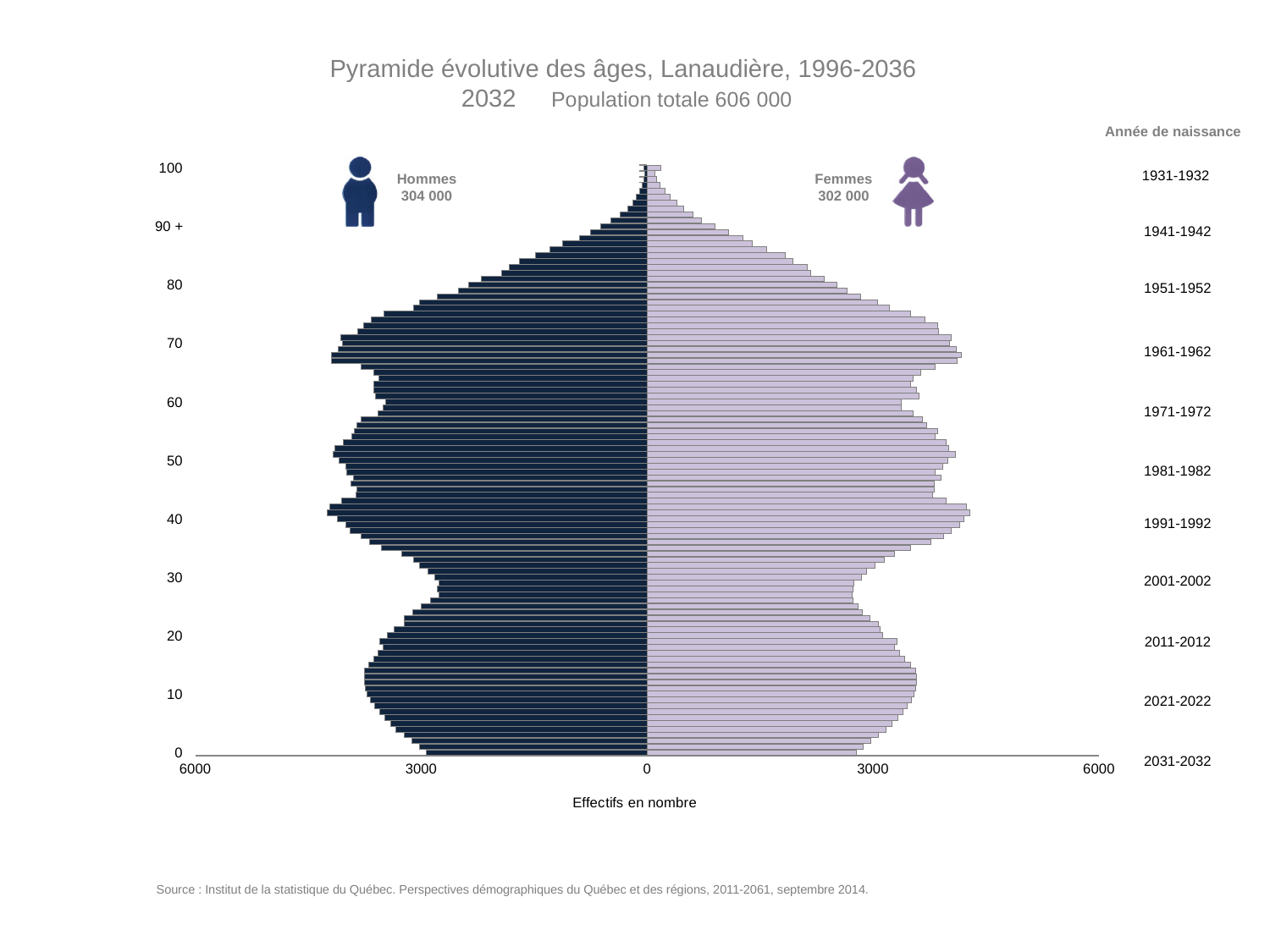
Which group is larger, Hommes or Femmes? Hommes What is the number of Femmes shown on the chart? 302 000 Is the value for Femmes at age 90+ greater or less than 3000? less Is the value for Hommes at age 10 greater or less than 3000? greater What is the number of Hommes shown on the chart? 304 000 Do the bars for Hommes rise or fall as age increases from 70 to 100? fall How many population groups (series) does the chart show? 2 What is the total population shown for 2032? 606 000 What kind of chart is shown on the slide? bar chart (population pyramid) Which year does the pyramid on the slide represent? 2032 What is the difference between the number of Hommes and the number of Femmes? 2 000 Is the value for Hommes at age 40 greater or less than 3000? greater